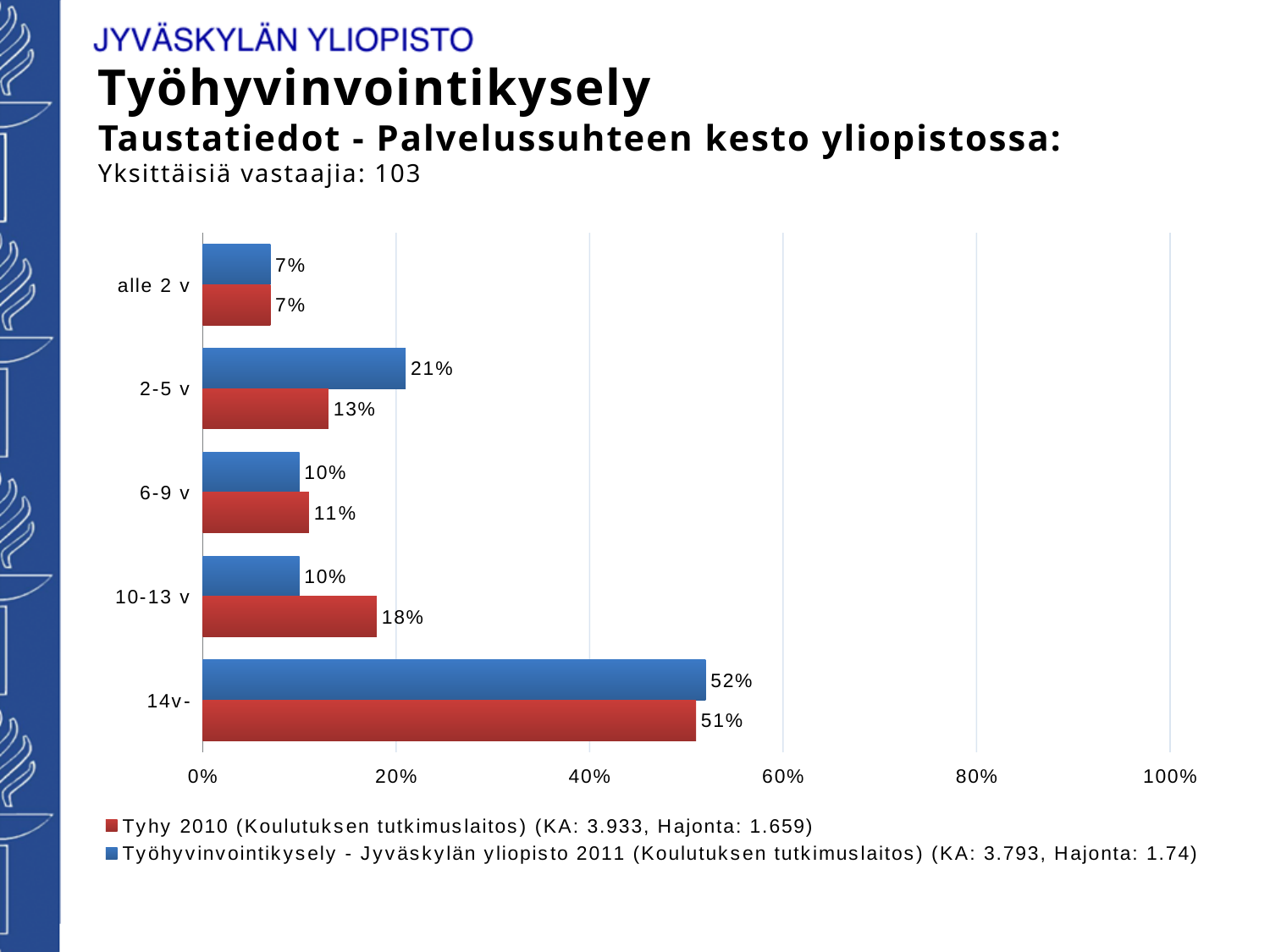
For '10-13 v', which series has the larger value, Tyhy 2010 or Työhyvinvointikysely 2011? Tyhy 2010 Which colour represents the Tyhy 2010 series in the chart? red What is the value for '2-5 v' in the Työhyvinvointikysely - Jyväskylän yliopisto 2011 series? 21% Is the value for '14v-' in the Tyhy 2010 series greater or less than 40%? greater Which category has the highest value in the Tyhy 2010 series? 14v- What kind of chart is shown on the slide? bar chart Which category has the lowest value in the Työhyvinvointikysely - Jyväskylän yliopisto 2011 series? alle 2 v What is the value for '10-13 v' in the Tyhy 2010 series? 18% What is the difference between the 2011 and 2010 values for '2-5 v'? 8% How many categories of service duration are shown on the chart? 5 How many series does the legend list? 2 What is the value for '14v-' in the Työhyvinvointikysely - Jyväskylän yliopisto 2011 series? 52%